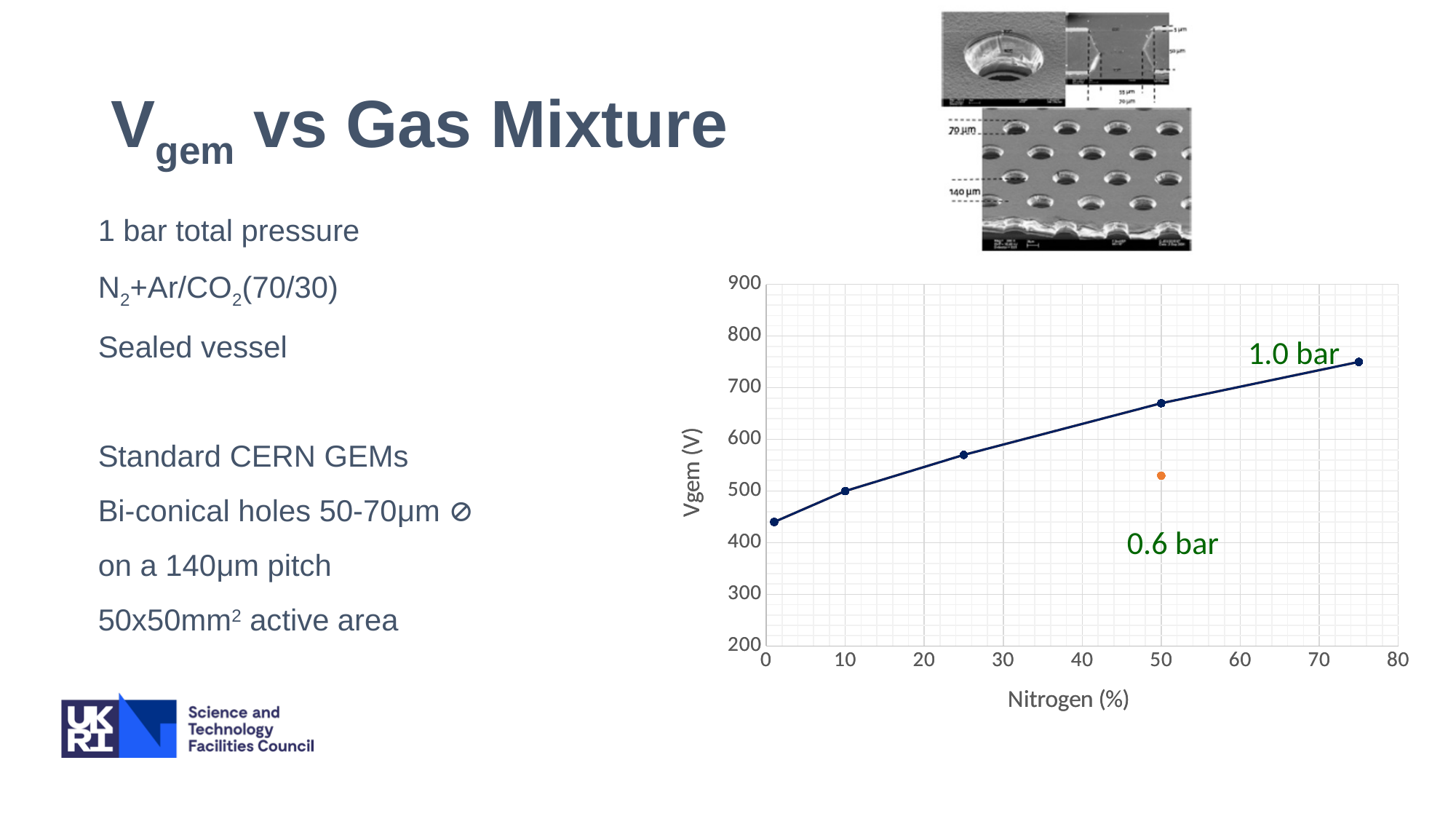
Is the 1.0 bar Vgem value at 50% nitrogen greater or less than 600? greater What kind of chart is shown on the slide? line chart Is the 0.6 bar Vgem value at 50% nitrogen greater or less than 600? less How many data points are plotted on the 1.0 bar line? 5 What is the label of the x axis of the chart? Nitrogen (%) Is the 1.0 bar Vgem value at 25% nitrogen greater or less than 600? less Does Vgem rise or fall as the nitrogen percentage increases along the 1.0 bar line? rises At which nitrogen percentage is Vgem highest on the 1.0 bar line? 75 At 50% nitrogen, which has the larger Vgem: the 1.0 bar point or the 0.6 bar point? 1.0 bar What is the label of the y axis of the chart? Vgem (V)